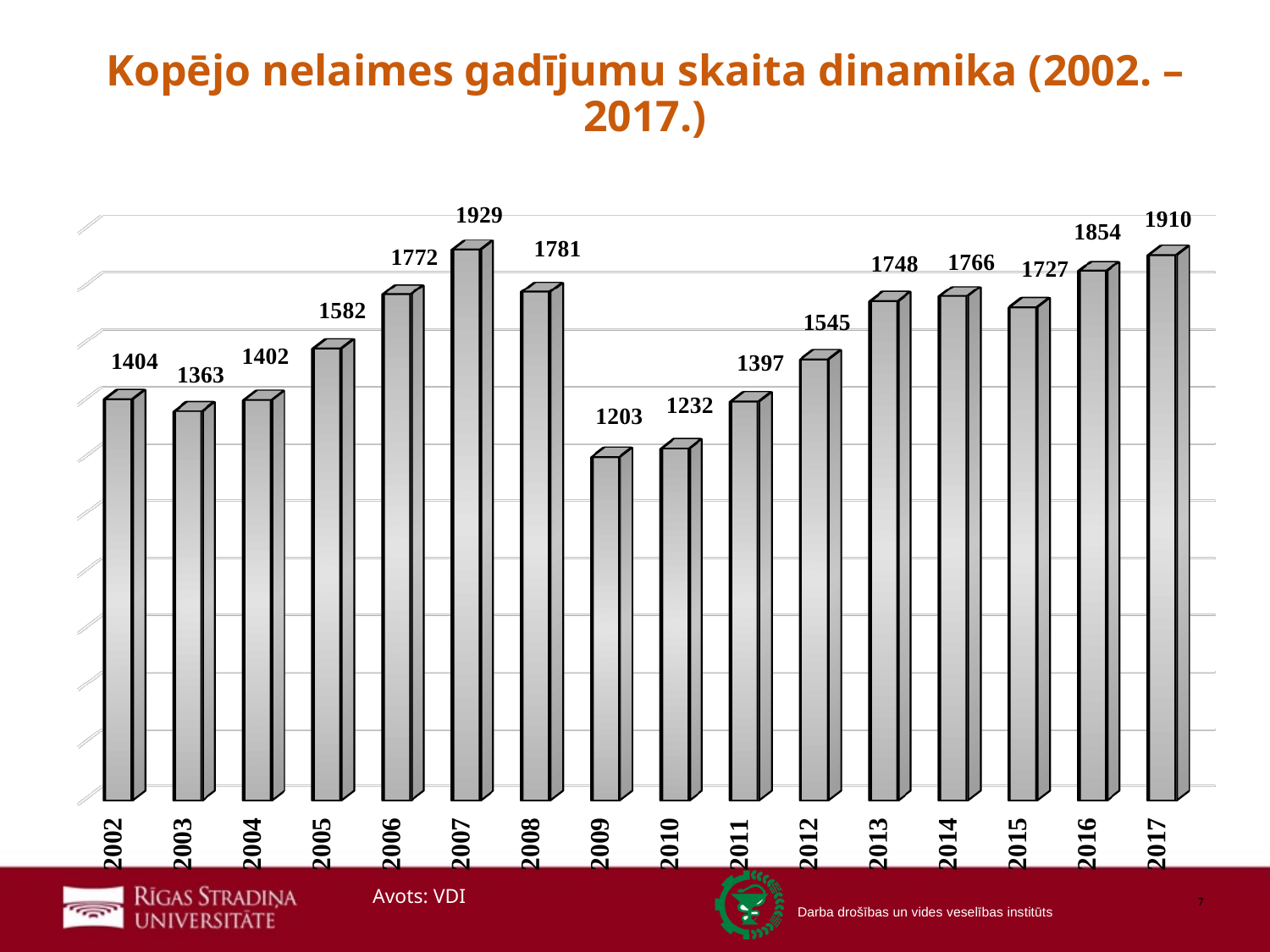
What kind of chart is shown on the slide? bar chart Which is larger, the value for 2006 or the value for 2008? 2008 What is the difference between the values for 2008 and 2009? 578 Which is larger, the value for 2002 or the value for 2004? 2002 What is the value for 2013? 1748 What is the value for 2007? 1929 What is the value for 2009? 1203 Which year has the lowest value? 2009 How many years are shown on the x axis? 16 Do the values rise or fall from 2009 to 2017? rise Which year has the highest value? 2007 What is the difference between the values for 2017 and 2016? 56